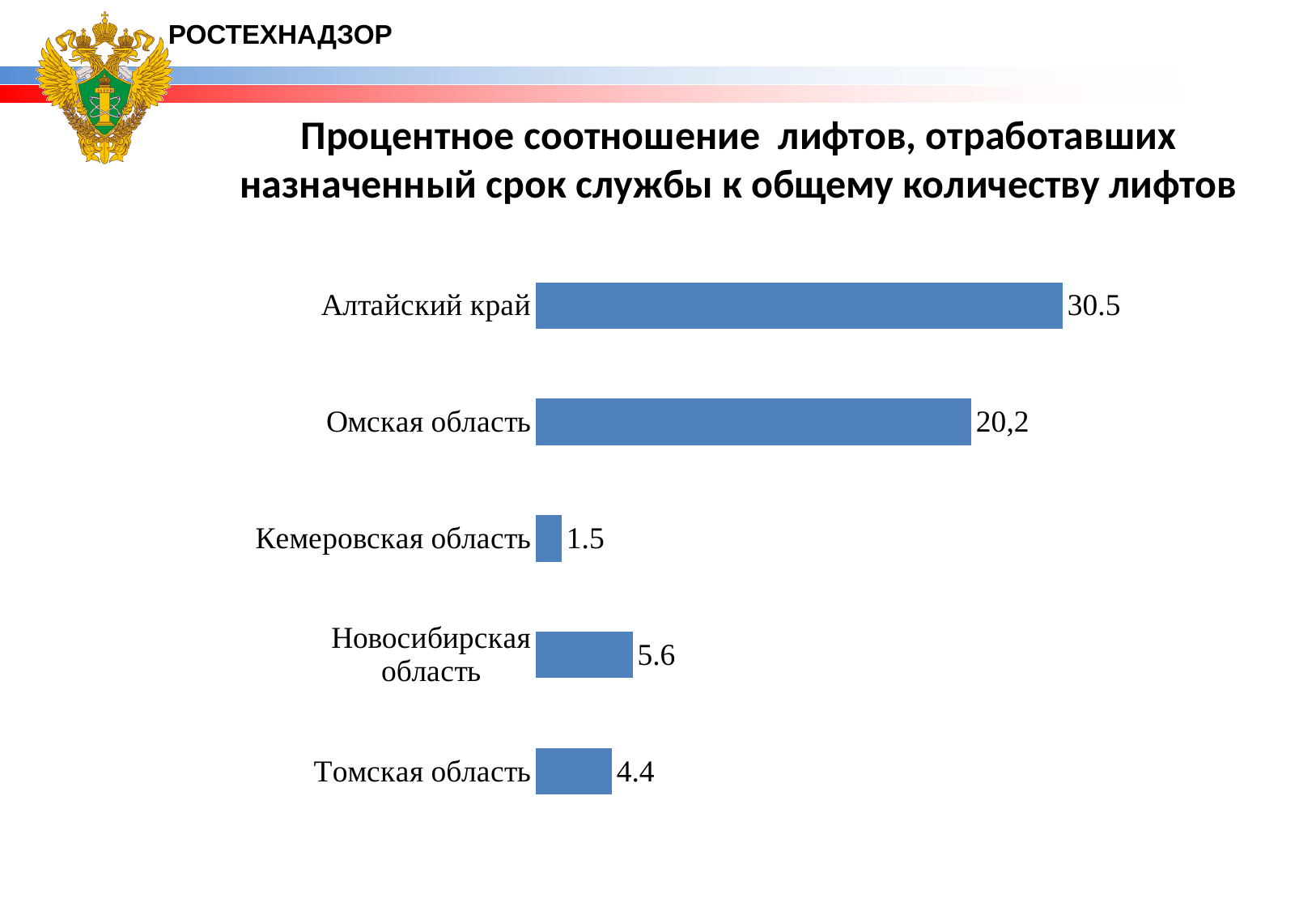
Which region has the highest value? Алтайский край What is the value for Томская область? 4.4 Which is larger, the value for Новосибирская область or Томская область? Новосибирская область What is the difference between the values for Алтайский край and Кемеровская область? 29 What is the value for Новосибирская область? 5.6 What is the value for Алтайский край? 30.5 What is the value shown for Омская область? 20,2 What is the value for Кемеровская область? 1.5 What is the difference between the values for Новосибирская область and Томская область? 1.2 What kind of chart is shown on the slide? bar chart How many regions are shown in the chart? 5 Which region has the lowest value? Кемеровская область